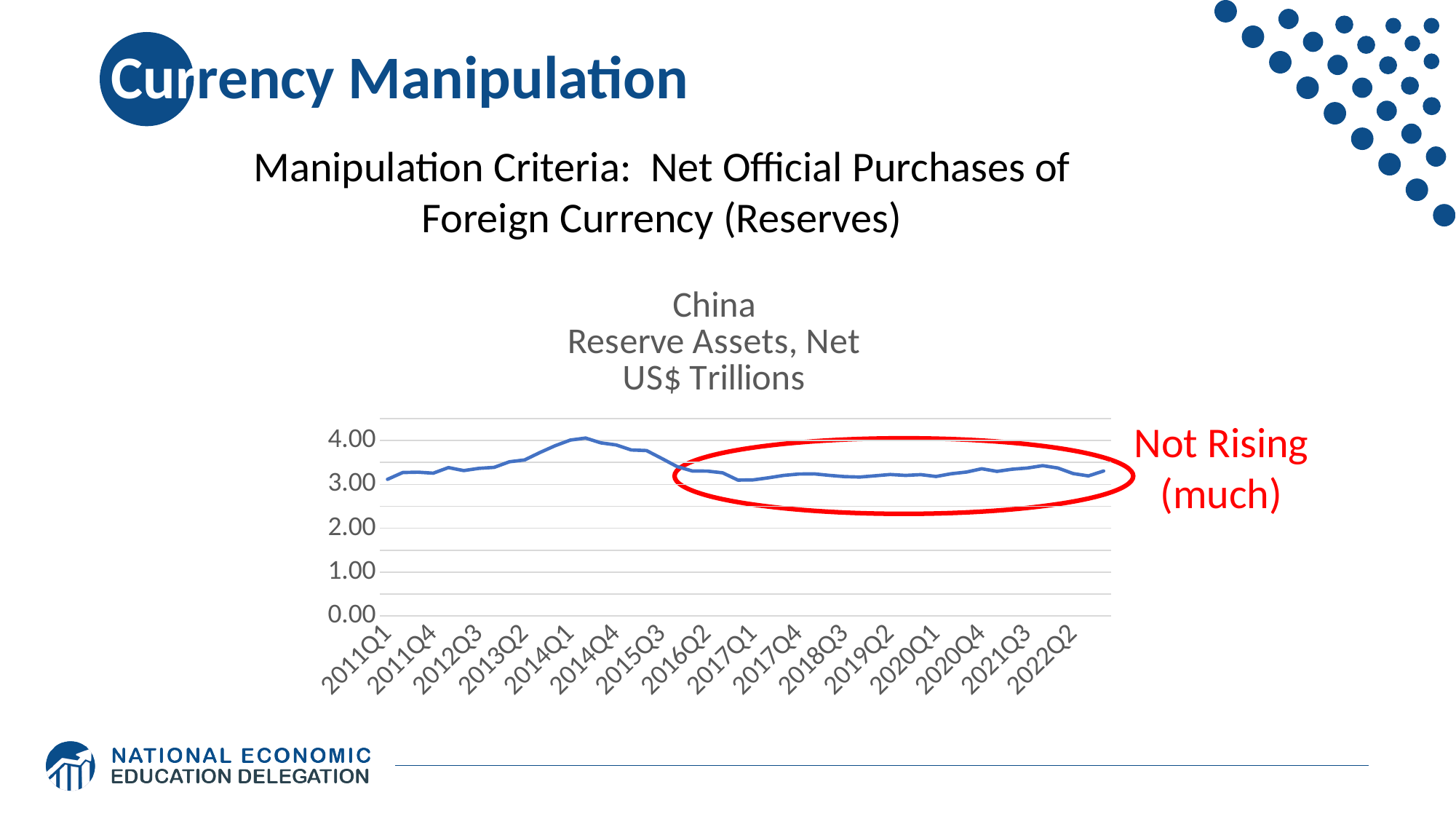
How many quarter labels are shown along the x axis? 16 Around which labeled quarter does the line reach its highest point? 2014Q1 Is the value for 2022Q2 greater or less than 2.00? greater What kind of chart is shown on the slide? line chart Is the value for 2017Q1 greater or less than 4.00? less Is the value for 2014Q1 greater or less than 3.00? greater Which is larger, the value for 2014Q1 or the value for 2017Q1? 2014Q1 Does the line rise or fall between 2011Q1 and 2014Q1? rise Does the line rise or fall between 2014Q1 and 2016Q2? fall What is the title of the chart? China Reserve Assets, Net US$ Trillions What does the red annotation next to the circled part of the chart say? Not Rising (much)